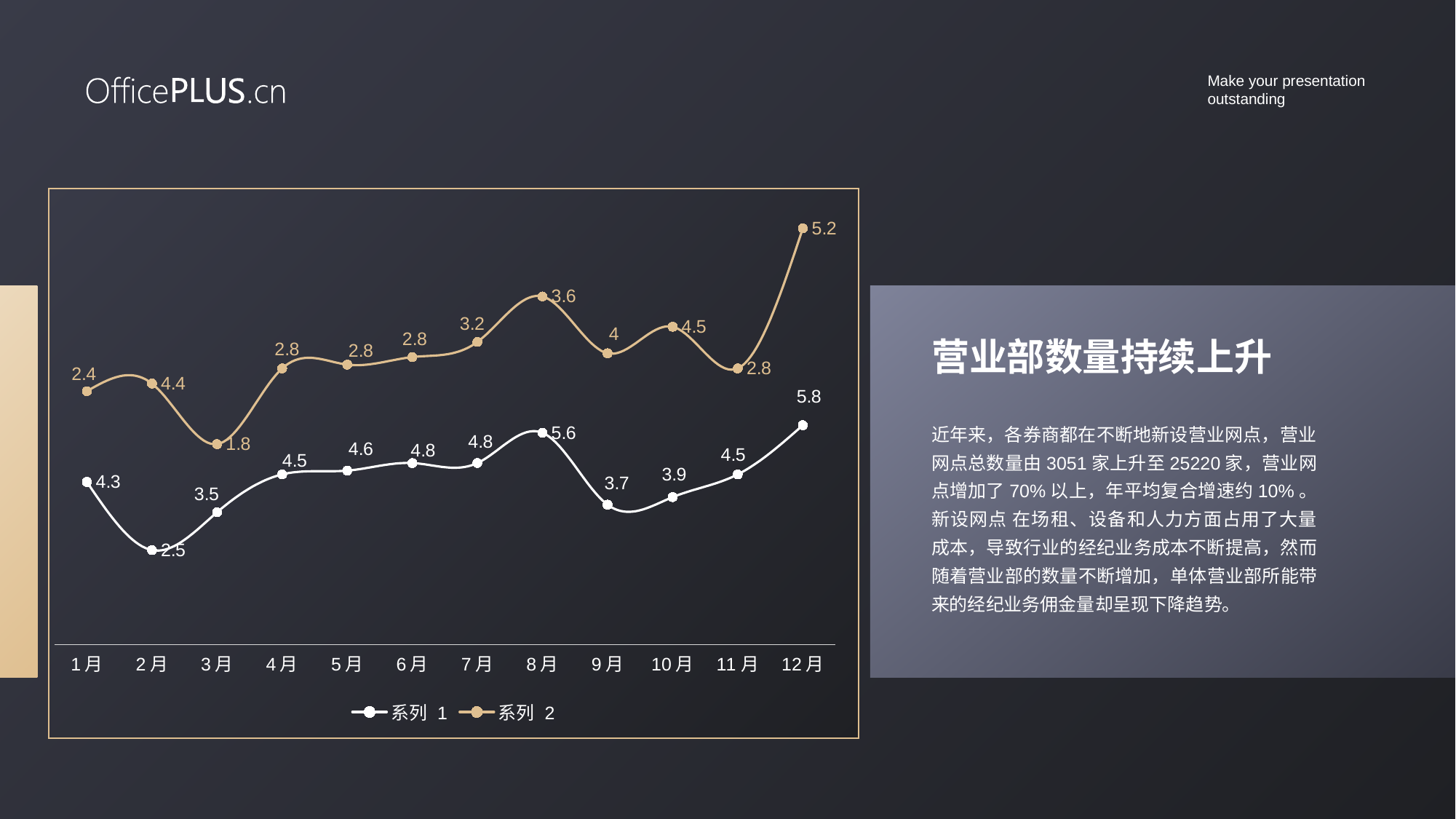
In which month does 系列 1 reach its highest value? 12月 In which month does 系列 2 have its lowest value? 3月 In which month does 系列 1 have its lowest value? 2月 How many series does the legend list? 2 What is the value of 系列 1 in 8月? 5.6 What kind of chart is shown on the slide? Line chart What is the value of 系列 2 in 3月? 1.8 Which is larger, the 系列 1 value in 2月 or the 系列 2 value in 2月? 系列 2 What is the value of 系列 2 in 12月? 5.2 What is the difference between the 系列 1 values in 12月 and 1月? 1.5 What is the difference between the 系列 2 values in 8月 and 7月? 0.4 How many months are shown on the x axis? 12